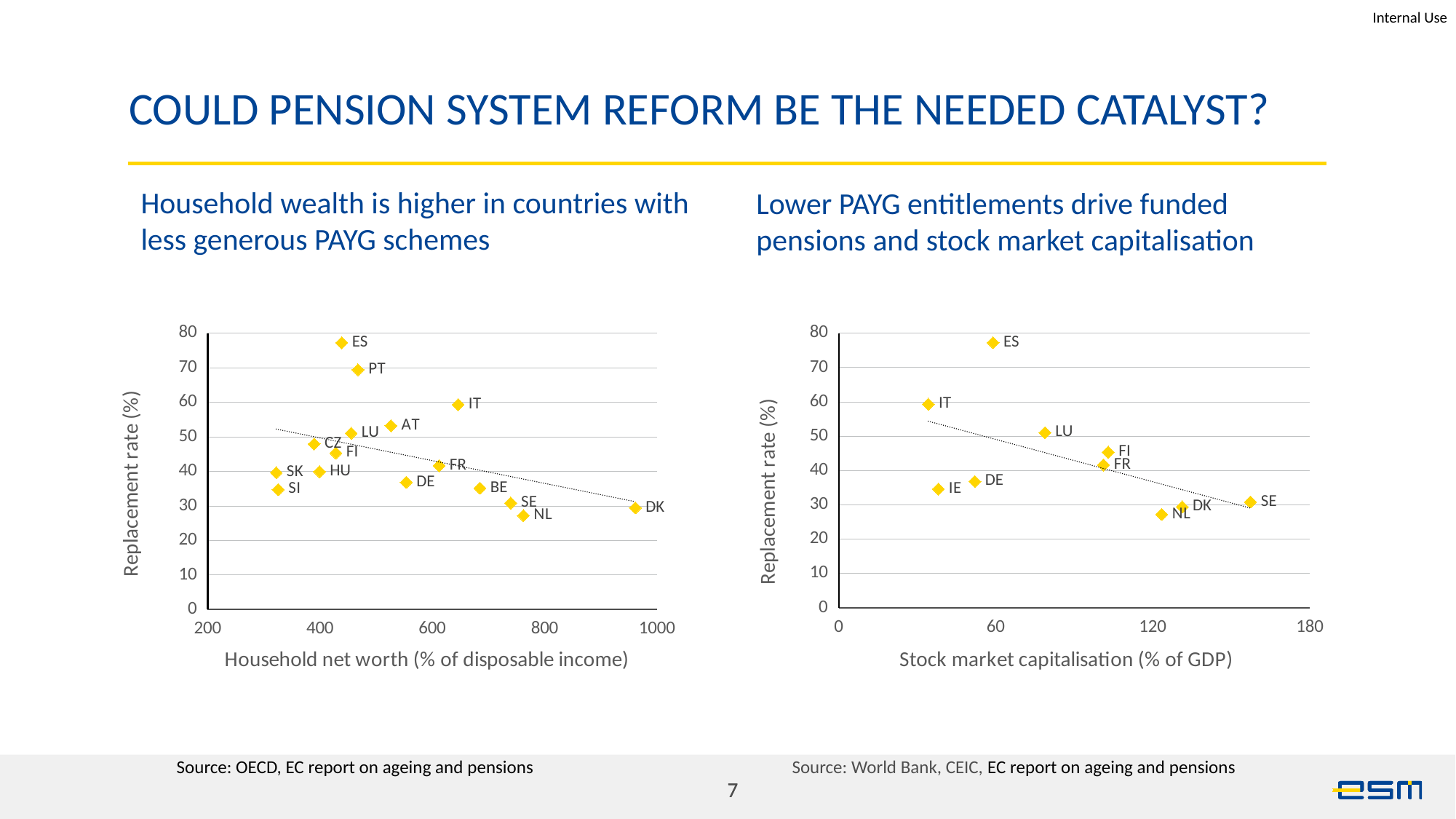
In the right chart, is the stock market capitalisation for IT greater or less than 60? less In the left chart (household net worth vs replacement rate), which country has the highest replacement rate? ES How many country points are plotted in the right chart (stock market capitalisation vs replacement rate)? 10 In the left chart (household net worth vs replacement rate), which country has the highest household net worth? DK In the left chart, which has the higher replacement rate, PT or IT? PT In the right chart (stock market capitalisation vs replacement rate), which country has the highest stock market capitalisation? SE In the left chart, is the replacement rate for ES greater or less than 70? greater In the right chart (stock market capitalisation vs replacement rate), which country has the lowest replacement rate? NL In the right chart, does the trend line show the replacement rate rising or falling as stock market capitalisation increases? Falling In the left chart (household net worth vs replacement rate), which country has the lowest replacement rate? NL What kind of chart is the left chart, 'Household wealth is higher in countries with less generous PAYG schemes'? Scatter chart How many country points are plotted in the left chart (household net worth vs replacement rate)? 16